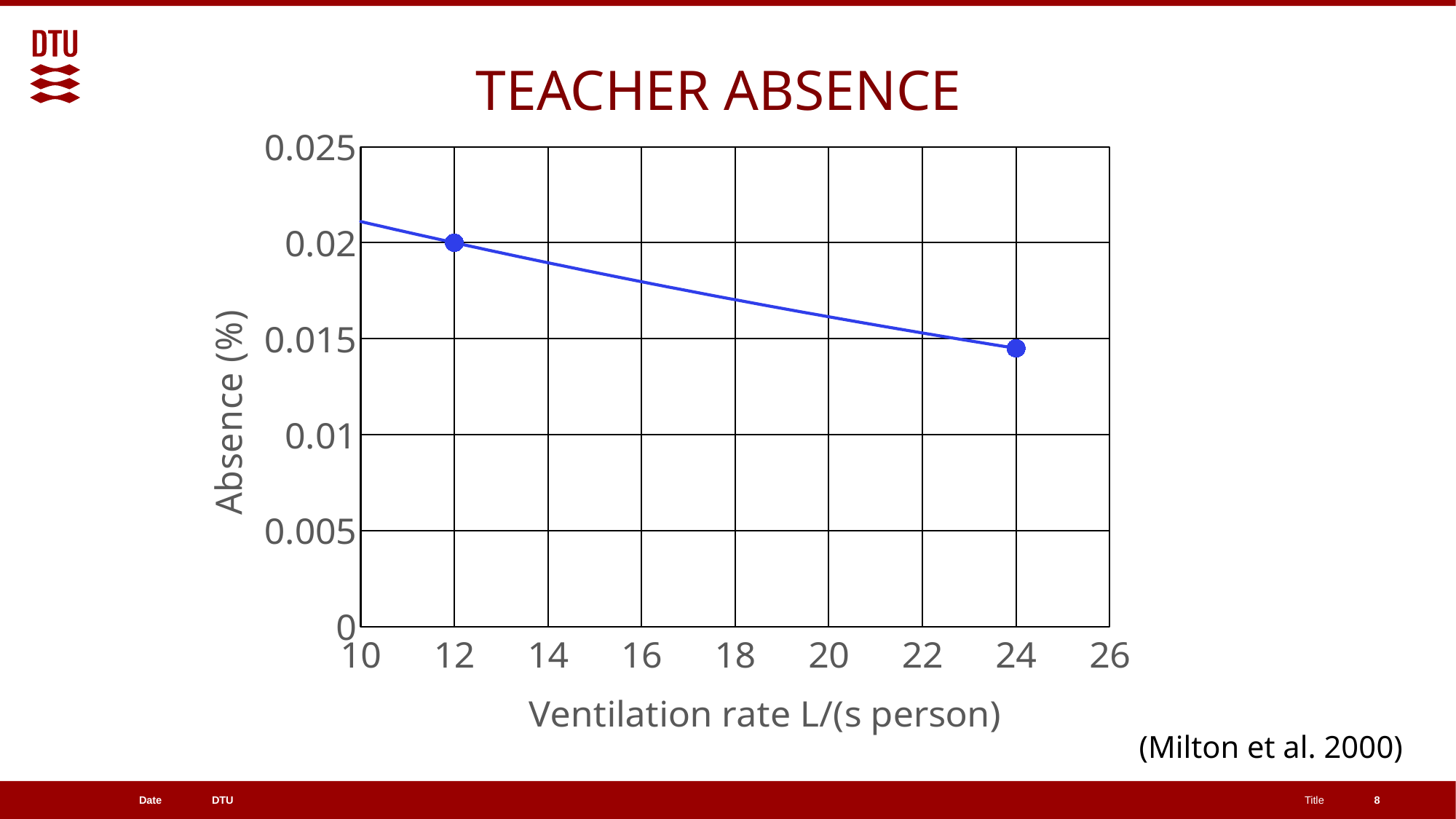
Is the absence value at a ventilation rate of 24 L/(s person) greater or less than 0.01? greater What is the label of the x axis? Ventilation rate L/(s person) What is the title of the chart? TEACHER ABSENCE Do the absence values rise or fall as the ventilation rate increases? fall Which has the larger absence value: a ventilation rate of 12 or 24 L/(s person)? 12 What is the absence value at a ventilation rate of 12 L/(s person)? 0.02 At which ventilation rate is the absence value lowest? 24 What kind of chart is shown on the slide? line chart At which ventilation rate is the absence value highest? 12 How many data points are plotted on the chart? 2